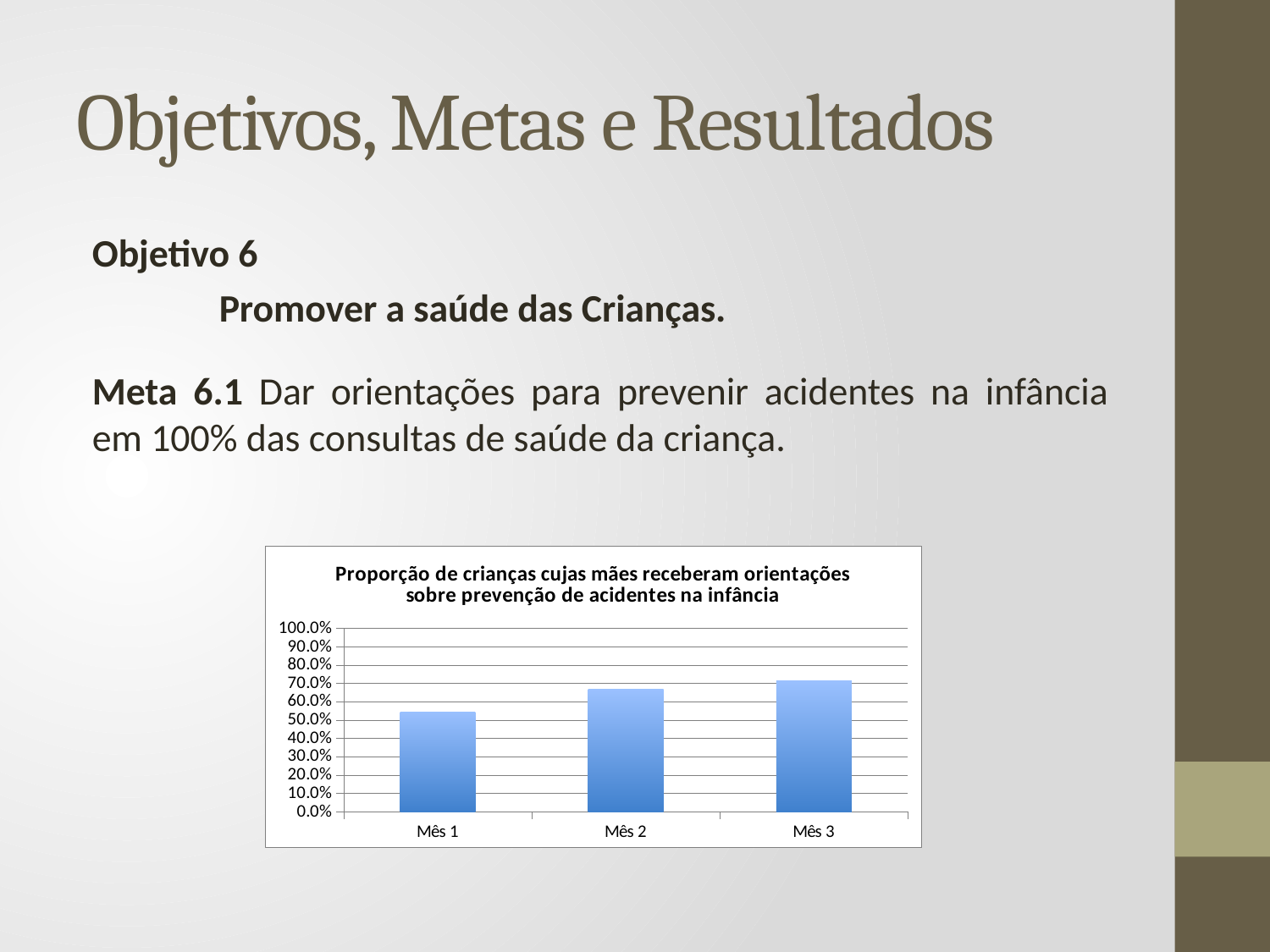
Which month has the lowest proportion on the chart? Mês 1 How many categories (months) are plotted on the chart? 3 What is the title of the chart? Proporção de crianças cujas mães receberam orientações sobre prevenção de acidentes na infância Is the value for Mês 1 greater or less than 50.0%? greater Is the value for Mês 3 greater or less than 80.0%? less What kind of chart is shown on the slide? bar chart Do the values rise or fall from Mês 1 to Mês 3? rise Which month has the highest proportion on the chart? Mês 3 Is the value for Mês 1 greater or less than 60.0%? less Which is larger, the value for Mês 1 or the value for Mês 2? Mês 2